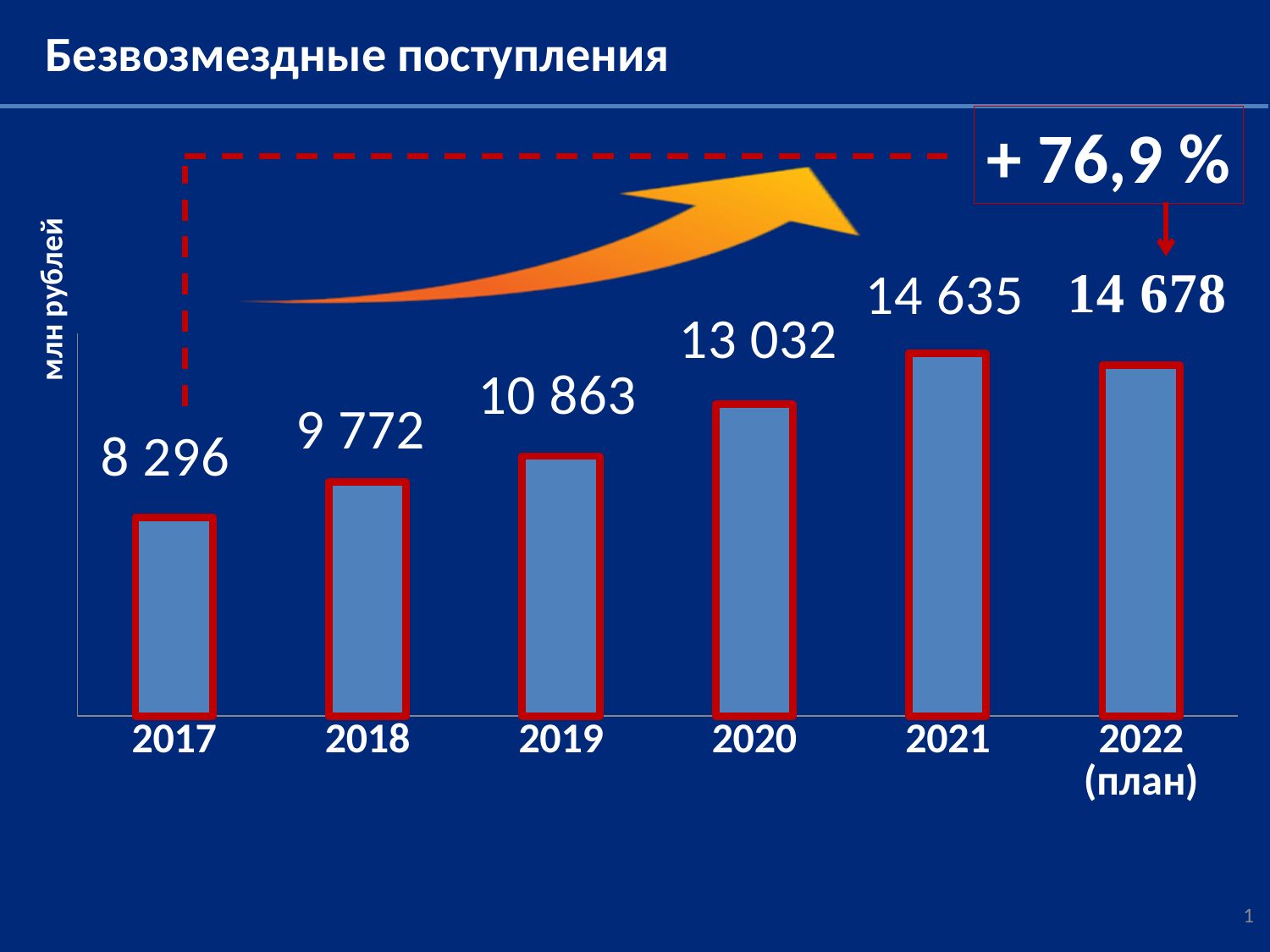
What is the planned value for 2022 (план)? 14 678 What is the value for 2020? 13 032 What kind of chart is shown on the slide? Bar chart Which is larger, the value for 2019 or the value for 2018? 2019 Do the values rise or fall from 2017 to 2022 (план)? Rise What percentage change is shown in the box at the top right of the chart? + 76,9 % Which year has the lowest value? 2017 What is the value for 2017? 8 296 What is the difference between the values for 2021 and 2020? 1 603 What is the difference between the values for 2022 (план) and 2017? 6 382 How many years are shown on the chart? 6